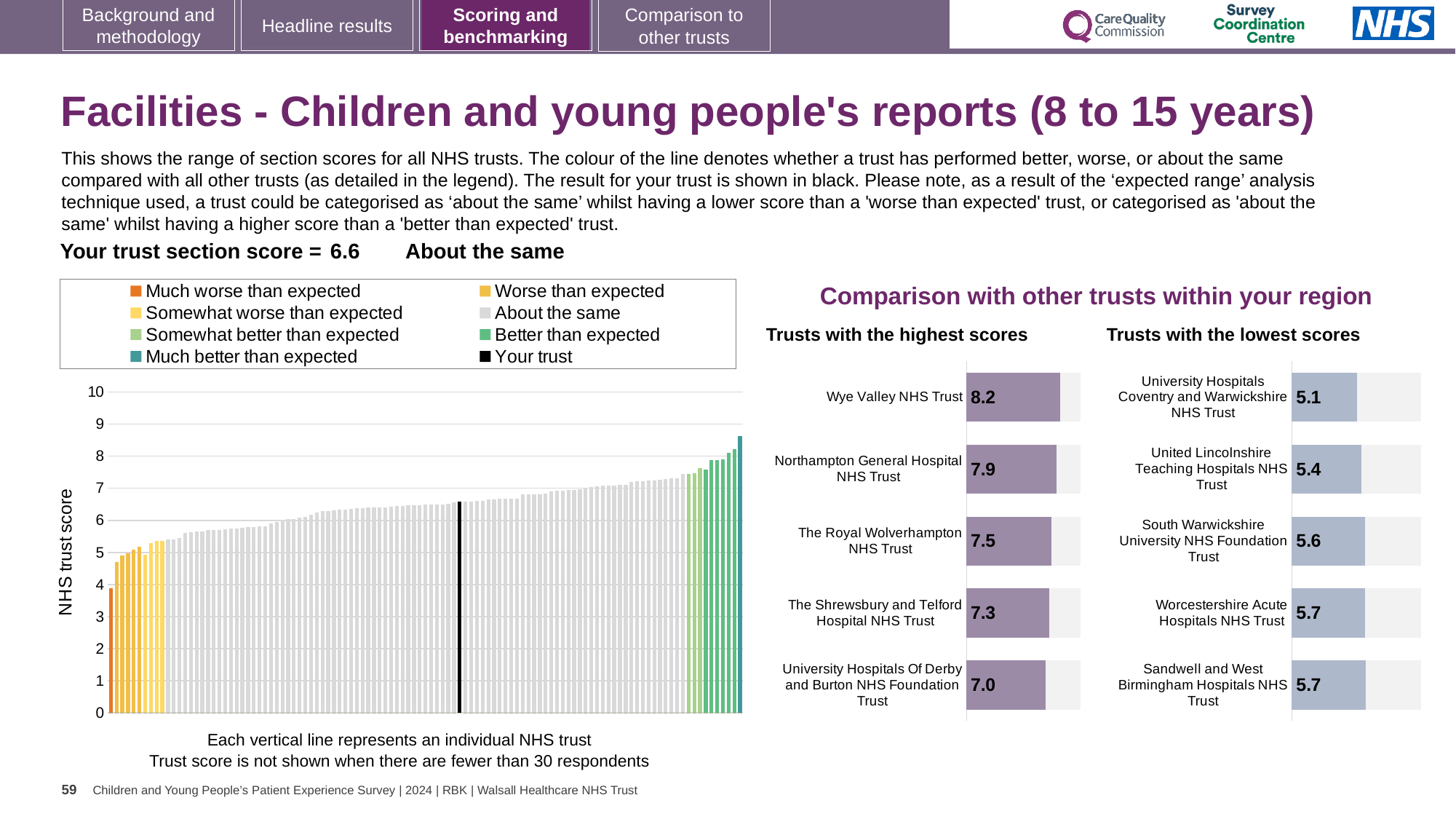
What kind of chart is the large chart on the left showing NHS trust scores? Bar chart In the 'Trusts with the lowest scores' chart, which trust has the lowest score? University Hospitals Coventry and Warwickshire NHS Trust In the 'Trusts with the highest scores' chart, which trust has the highest score? Wye Valley NHS Trust How many trusts are shown in the 'Trusts with the lowest scores' chart? 5 In the large chart on the left, is the value of the tallest bar greater or less than 8? greater In the 'Trusts with the highest scores' chart, what is the score for Northampton General Hospital NHS Trust? 7.9 In the 'Trusts with the lowest scores' chart, what is the score for Worcestershire Acute Hospitals NHS Trust? 5.7 In the 'Trusts with the highest scores' chart, which has the higher score: The Royal Wolverhampton NHS Trust or The Shrewsbury and Telford Hospital NHS Trust? The Royal Wolverhampton NHS Trust In the 'Trusts with the highest scores' chart, what is the difference between the scores of Wye Valley NHS Trust and University Hospitals Of Derby and Burton NHS Foundation Trust? 1.2 In the 'Trusts with the lowest scores' chart, what is the score for University Hospitals Coventry and Warwickshire NHS Trust? 5.1 How many entries does the legend of the large chart on the left list? 8 In the 'Trusts with the highest scores' chart, what is the score for Wye Valley NHS Trust? 8.2